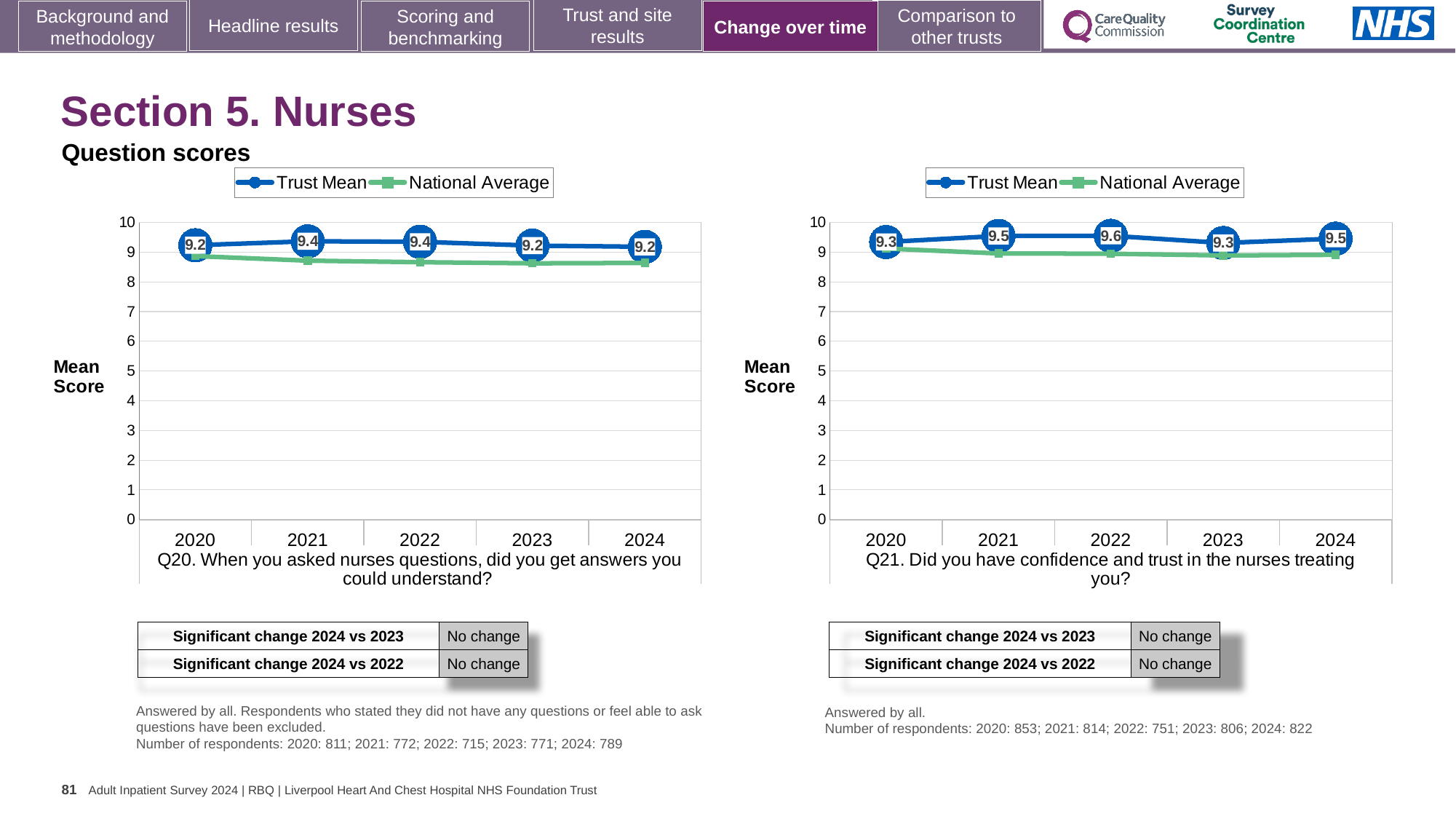
In the Q21 chart on the right, what is the Trust Mean score for 2024? 9.5 In the Q21 chart on the right, which year has the highest Trust Mean score? 2022 How many series does the legend of the Q20 chart on the left list? 2 In the Q20 chart on the left, what is the Trust Mean score for 2020? 9.2 In the Q21 chart on the right, does the Trust Mean score rise or fall from 2023 to 2024? Rise In the Q20 chart on the left, is the National Average value for 2024 greater or less than 8? greater In the Q20 chart on the left, is the Trust Mean score higher in 2021 or in 2024? 2021 In the Q20 chart on the left, what is the Trust Mean score for 2021? 9.4 What are the two series named in the legend of the Q21 chart on the right? Trust Mean and National Average In the Q21 chart on the right, what is the difference between the Trust Mean scores for 2022 and 2023? 0.3 What type of chart is the Q21 chart on the right? Line chart How many years are plotted on the x axis of the Q21 chart on the right? 5